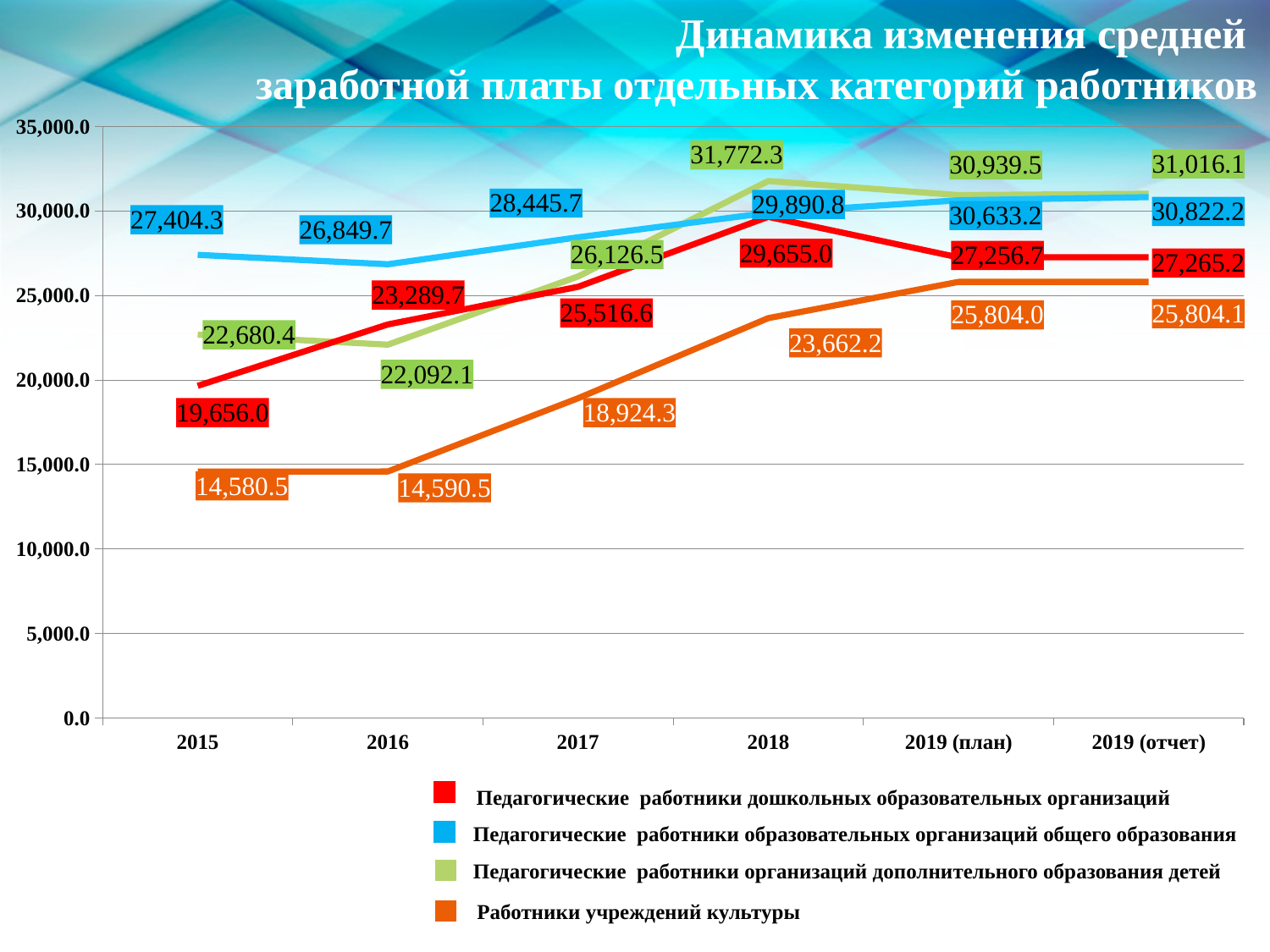
What is the difference between the 2018 and 2017 values for Работники учреждений культуры? 4,737.9 In 2016, which series has the larger value: Педагогические работники дошкольных образовательных организаций or Педагогические работники организаций дополнительного образования детей? Педагогические работники дошкольных образовательных организаций Which series is shown in orange in the legend? Работники учреждений культуры What type of chart is shown on the slide? line chart What is the value for Педагогические работники дошкольных образовательных организаций in 2018? 29,655.0 Does the value for Работники учреждений культуры rise or fall from 2015 to 2019 (отчет)? rise What is the value for Педагогические работники образовательных организаций общего образования in 2019 (отчет)? 30,822.2 How many series does the legend list? 4 In which year is the value for Педагогические работники организаций дополнительного образования детей highest? 2018 In which year is the value for Педагогические работники дошкольных образовательных организаций lowest? 2015 How many categories are shown on the x axis? 6 What is the value for Работники учреждений культуры in 2017? 18,924.3